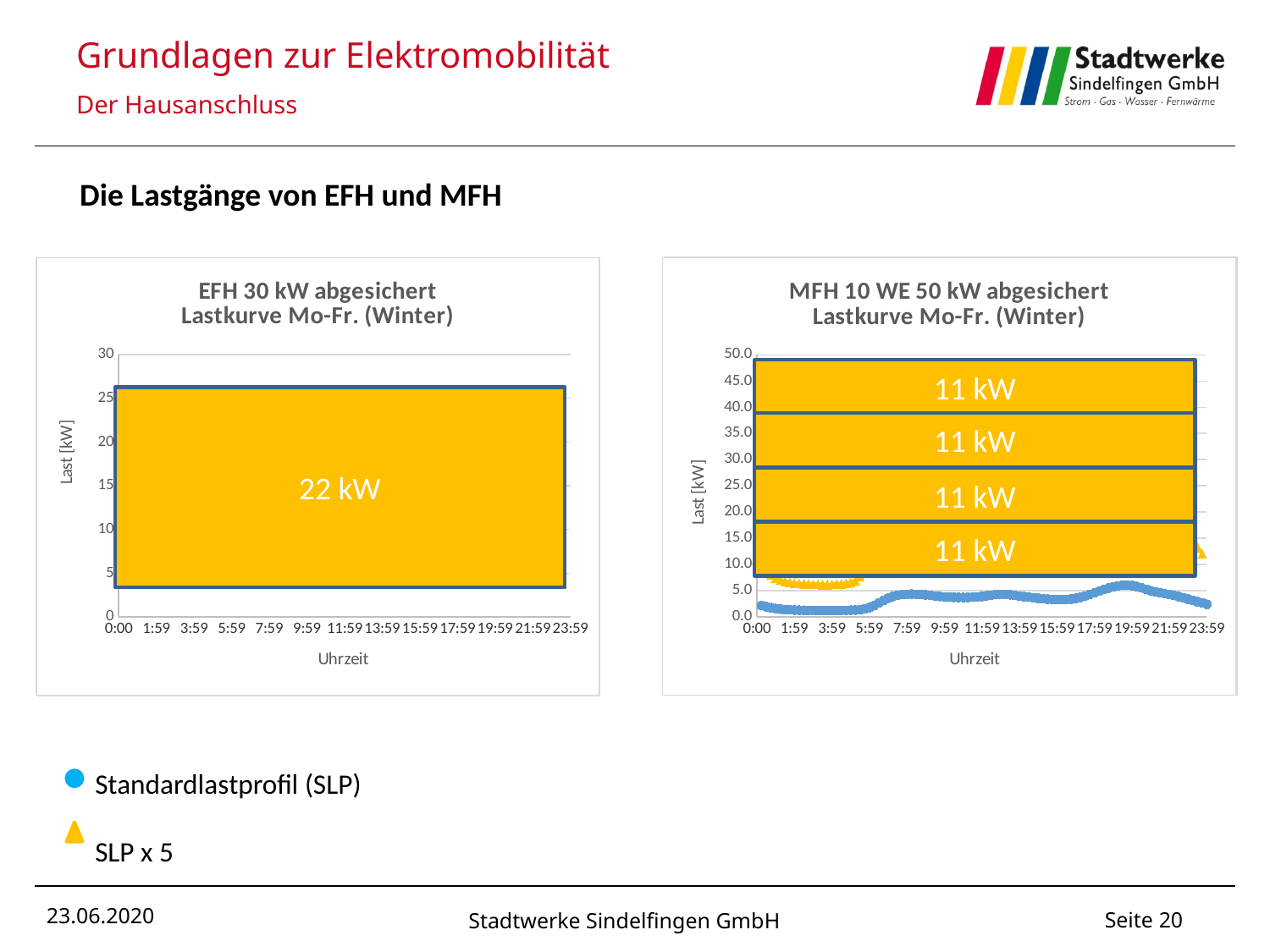
What is the difference between the 22 kW box in the left chart and one 11 kW box in the right chart? 11 kW In the left chart (EFH 30 kW abgesichert), what load value is printed inside the yellow box? 22 kW How many series does the legend below the charts list? 2 Which is larger: the 22 kW box in the left chart or a single 11 kW box in the right chart? 22 kW box in the left chart In the right chart (MFH 10 WE 50 kW abgesichert), what value is printed in each yellow box? 11 kW What is the x-axis label of the right chart (MFH 10 WE 50 kW abgesichert)? Uhrzeit What is the highest value shown on the y-axis of the right chart (MFH 10 WE 50 kW abgesichert)? 50.0 What is the highest value shown on the y-axis of the left chart (EFH 30 kW abgesichert)? 30 In the right chart (MFH 10 WE 50 kW abgesichert), is the value of the Standardlastprofil (SLP) line at 0:00 greater or less than 5.0? less How many yellow boxes labelled 11 kW are shown in the right chart (MFH 10 WE 50 kW abgesichert)? 4 What is the title of the chart on the left? EFH 30 kW abgesichert Lastkurve Mo-Fr. (Winter) In the right chart (MFH 10 WE 50 kW abgesichert), what is the total of the four stacked 11 kW boxes? 44 kW